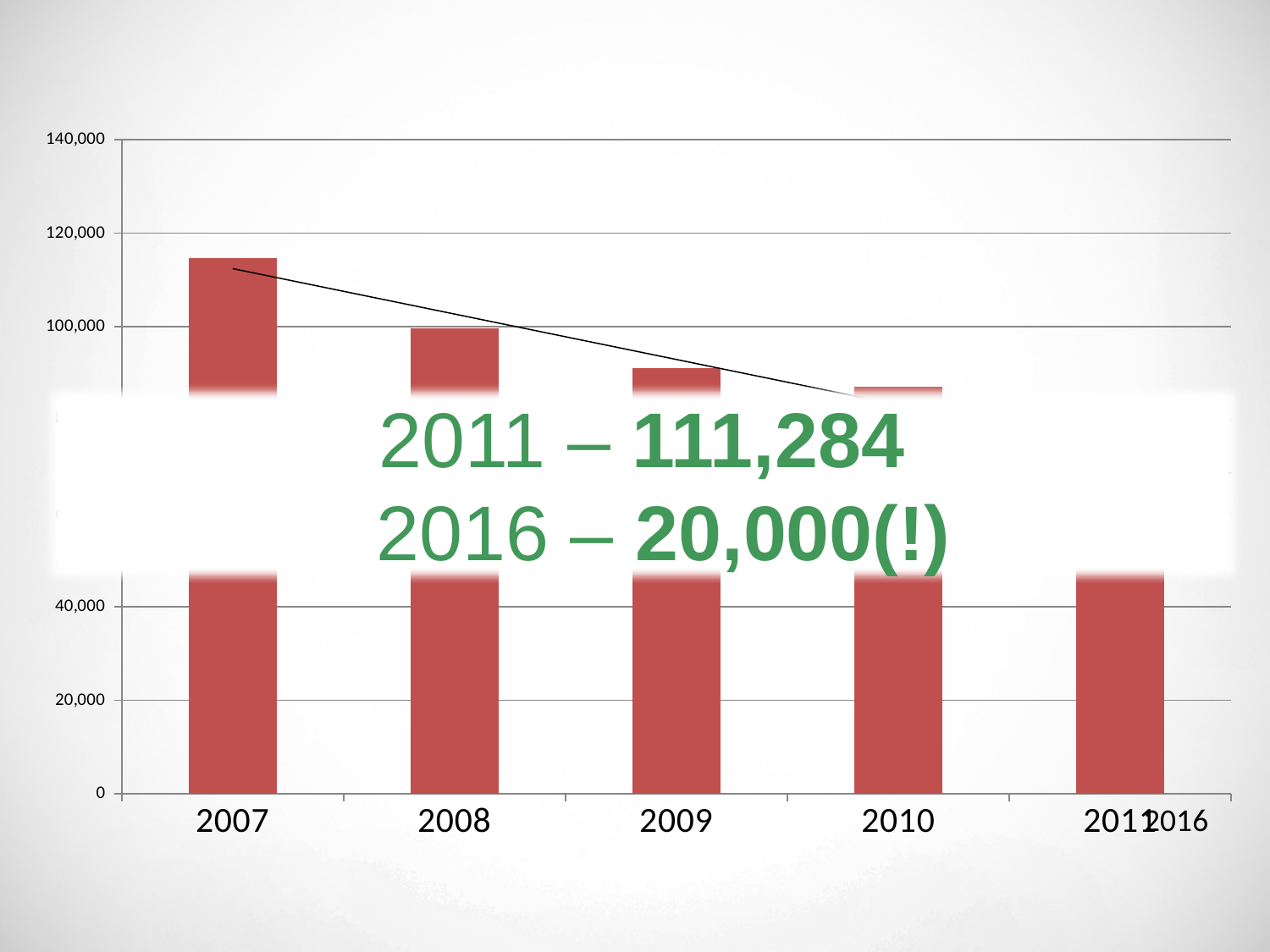
Which is larger, the value for 2008 or the value for 2010? 2008 How many bars are plotted in the chart? 5 Which year has the tallest bar in the chart? 2007 Is the value for 2009 greater or less than 100,000? less Is the value for 2010 greater or less than 100,000? less What kind of chart is shown on the slide? bar chart What value does the text overlaid on the chart give for 2011? 111,284 What value does the text overlaid on the chart give for 2016? 20,000(!) Do the bar values rise or fall from 2007 to 2010? fall Is the value for 2007 greater or less than 100,000? greater Which is larger, the value for 2007 or the value for 2008? 2007